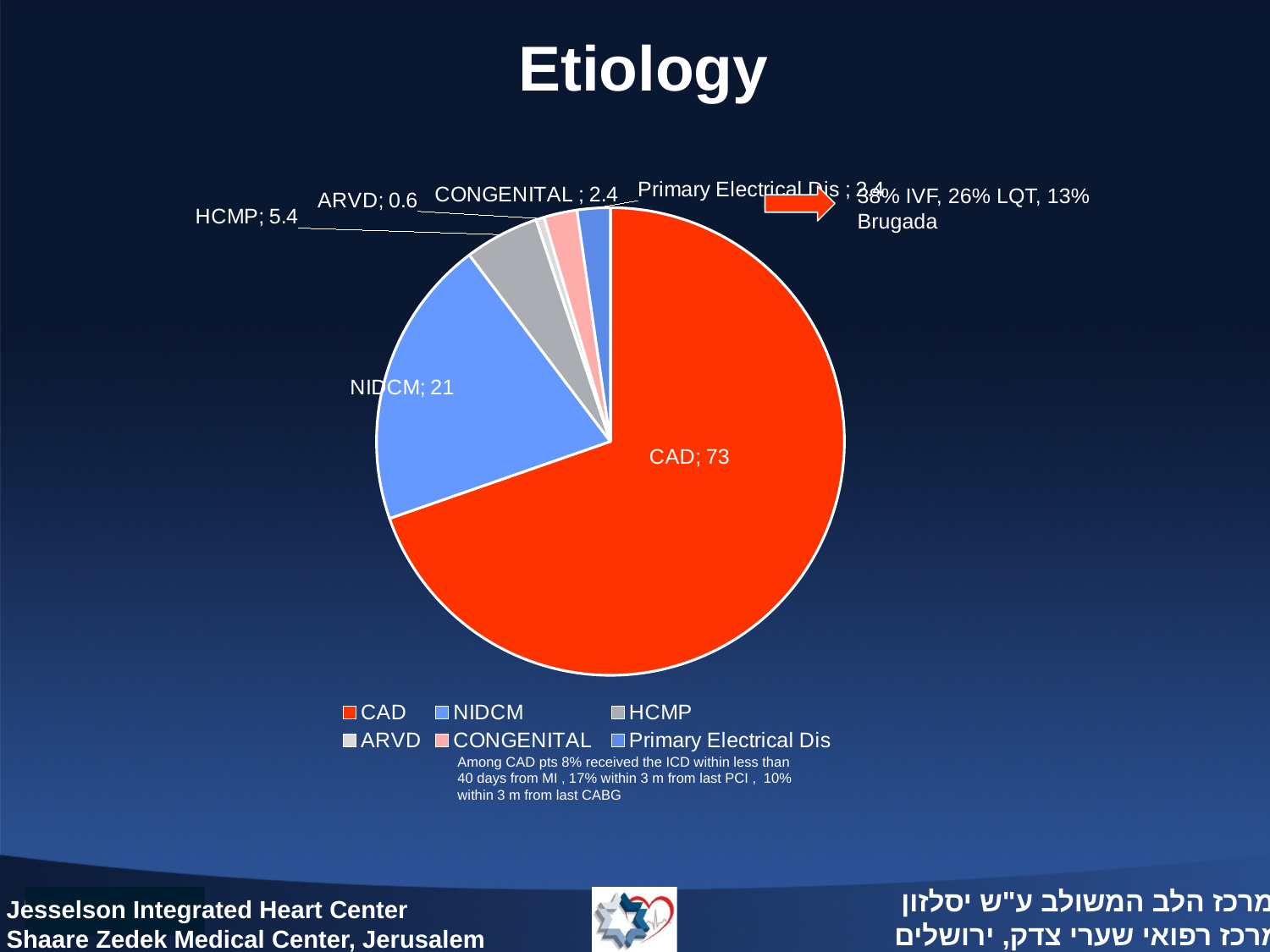
What kind of chart is shown on the slide? Pie chart What is the title of the slide containing the chart? Etiology Which category has the smallest slice in the pie chart? ARVD What value is shown for CAD in the pie chart? 73 What value is shown for NIDCM in the pie chart? 21 How many categories does the legend of the pie chart list? 6 Which category has the largest slice in the pie chart? CAD What value is shown for HCMP in the pie chart? 5.4 Which is larger, the value for HCMP or the value for CONGENITAL? HCMP What is the difference between the values for CAD and NIDCM? 52 What value is shown for CONGENITAL in the pie chart? 2.4 What value is shown for ARVD in the pie chart? 0.6